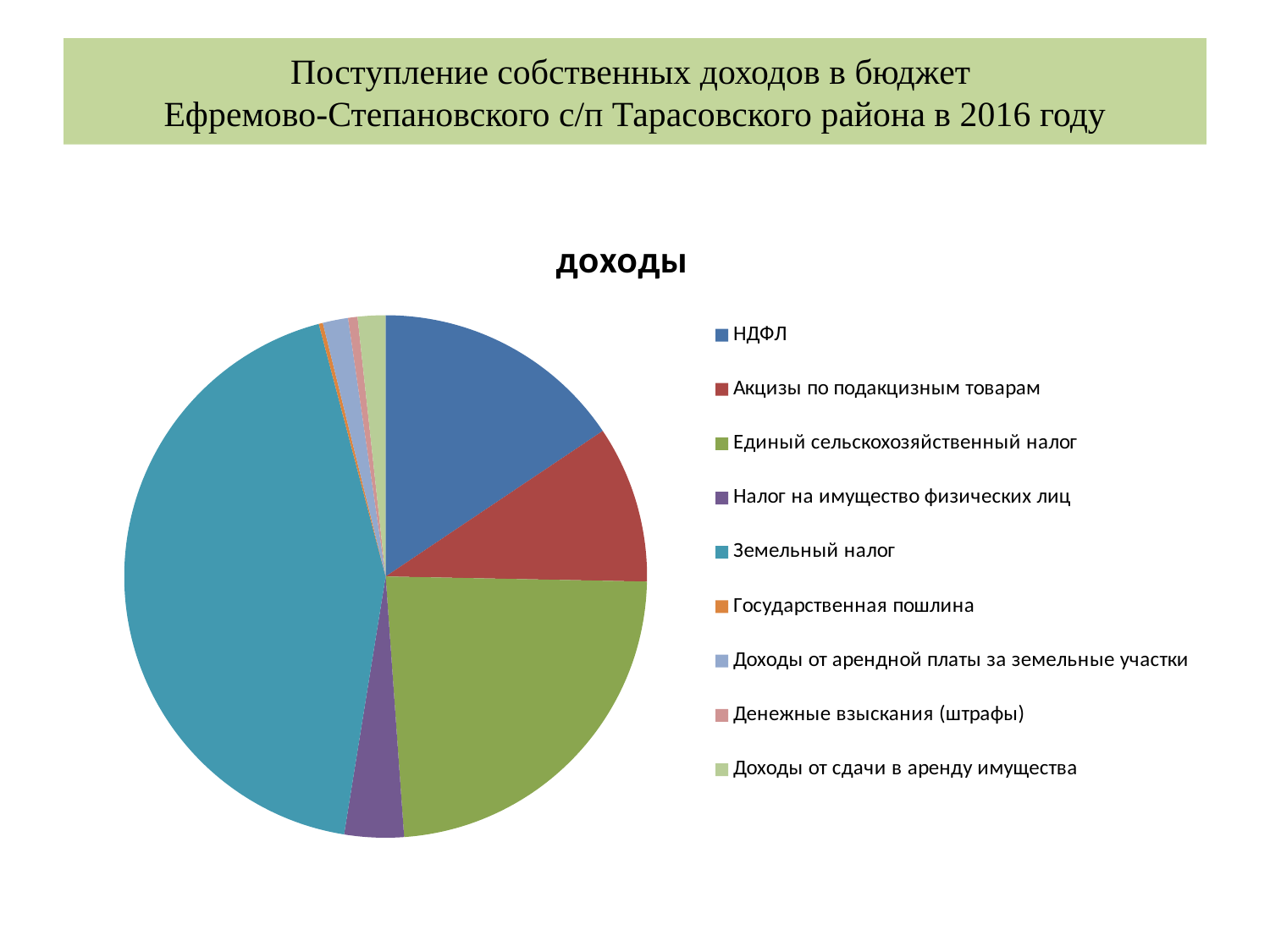
Which slice is larger in the pie chart: Единый сельскохозяйственный налог or НДФЛ? Единый сельскохозяйственный налог Which category is shown in the legend with the orange colour? Государственная пошлина Which category has the smallest slice in the pie chart "доходы"? Государственная пошлина What is the title of the pie chart? доходы Which category has the largest slice in the pie chart "доходы"? Земельный налог How many categories (slices) does the pie chart "доходы" have? 9 Which slice is larger in the pie chart: НДФЛ or Акцизы по подакцизным товарам? НДФЛ What kind of chart is shown on the slide? pie chart Which slice is larger in the pie chart: Налог на имущество физических лиц or Государственная пошлина? Налог на имущество физических лиц